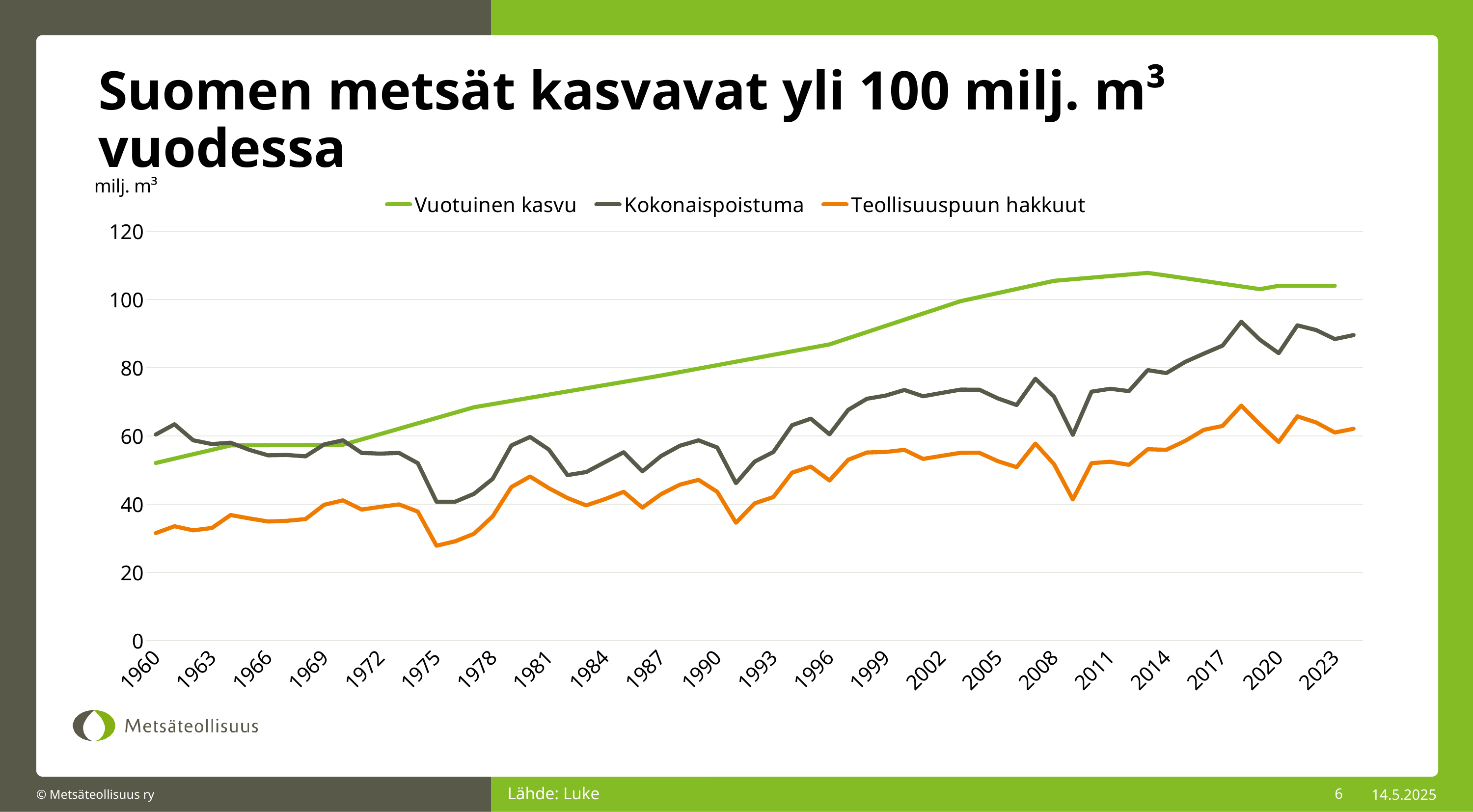
Does Vuotuinen kasvu generally rise or fall from 1960 to 2023? rise What unit is shown on the y axis? milj. m³ What kind of chart is shown on the slide? Line chart How many series does the legend list? 3 Which series is plotted in orange? Teollisuuspuun hakkuut Is the value for Teollisuuspuun hakkuut in 1975 greater or less than 40? less Which series has the lowest value in 2023? Teollisuuspuun hakkuut Is the value for Vuotuinen kasvu in 1960 greater or less than 60? less In 2023, which is larger: Vuotuinen kasvu or Kokonaispoistuma? Vuotuinen kasvu In 1960, which is larger: Kokonaispoistuma or Vuotuinen kasvu? Kokonaispoistuma Is the value for Kokonaispoistuma in 2018 greater or less than 80? greater